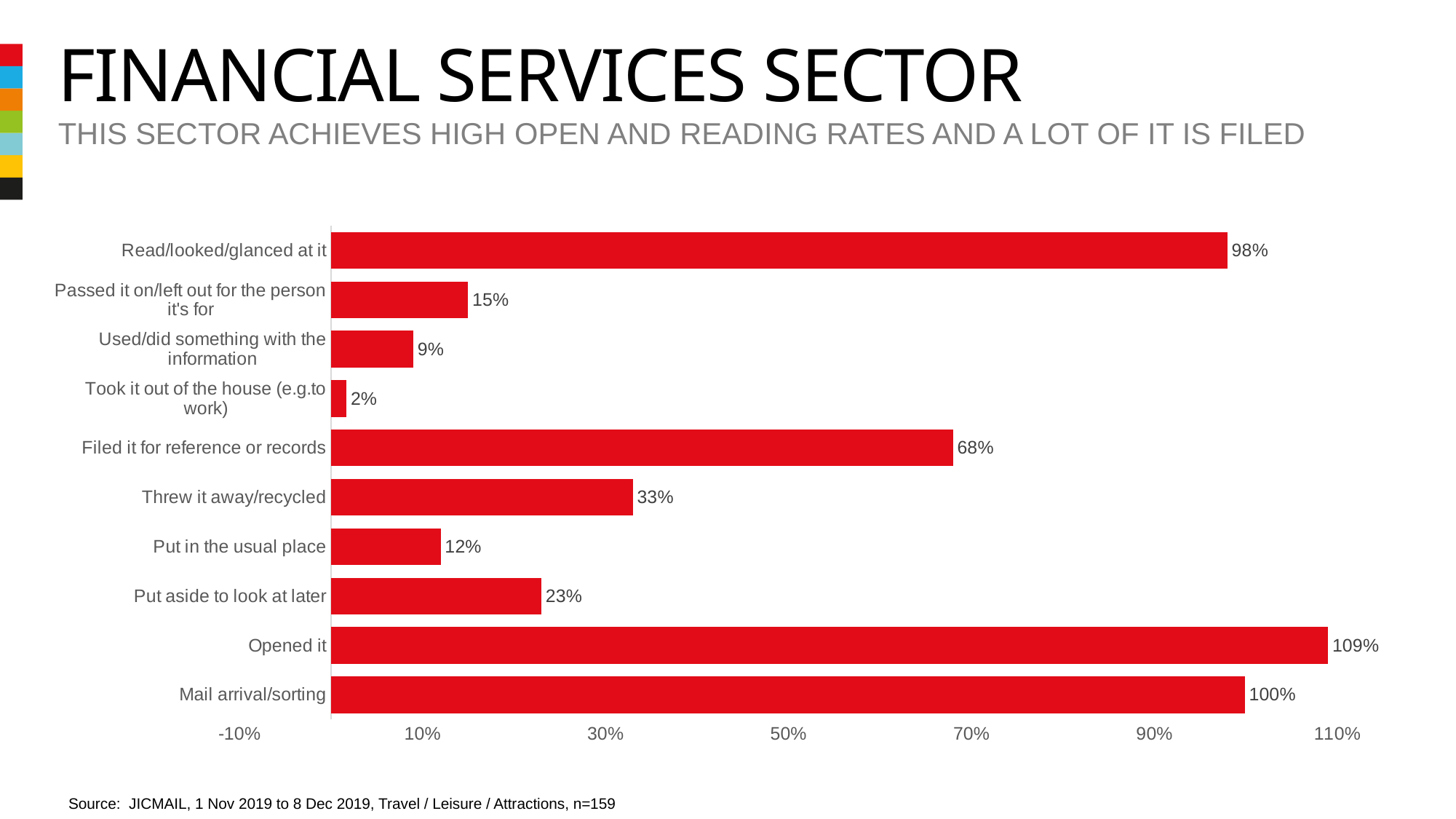
What colour are the bars in the chart? Red What is the value for "Filed it for reference or records"? 68% How many categories are shown in the chart? 10 Which category has the lowest value? Took it out of the house (e.g.to work) What kind of chart is shown on the slide? Bar chart Which category has the highest value? Opened it What is the value for "Took it out of the house (e.g.to work)"? 2% Is the value for "Filed it for reference or records" greater or less than 50%? greater What is the difference between the values for "Opened it" and "Read/looked/glanced at it"? 11% What is the value for "Threw it away/recycled"? 33% What is the value for "Put aside to look at later"? 23% Which is larger, the value for "Passed it on/left out for the person it's for" or the value for "Put in the usual place"? Passed it on/left out for the person it's for